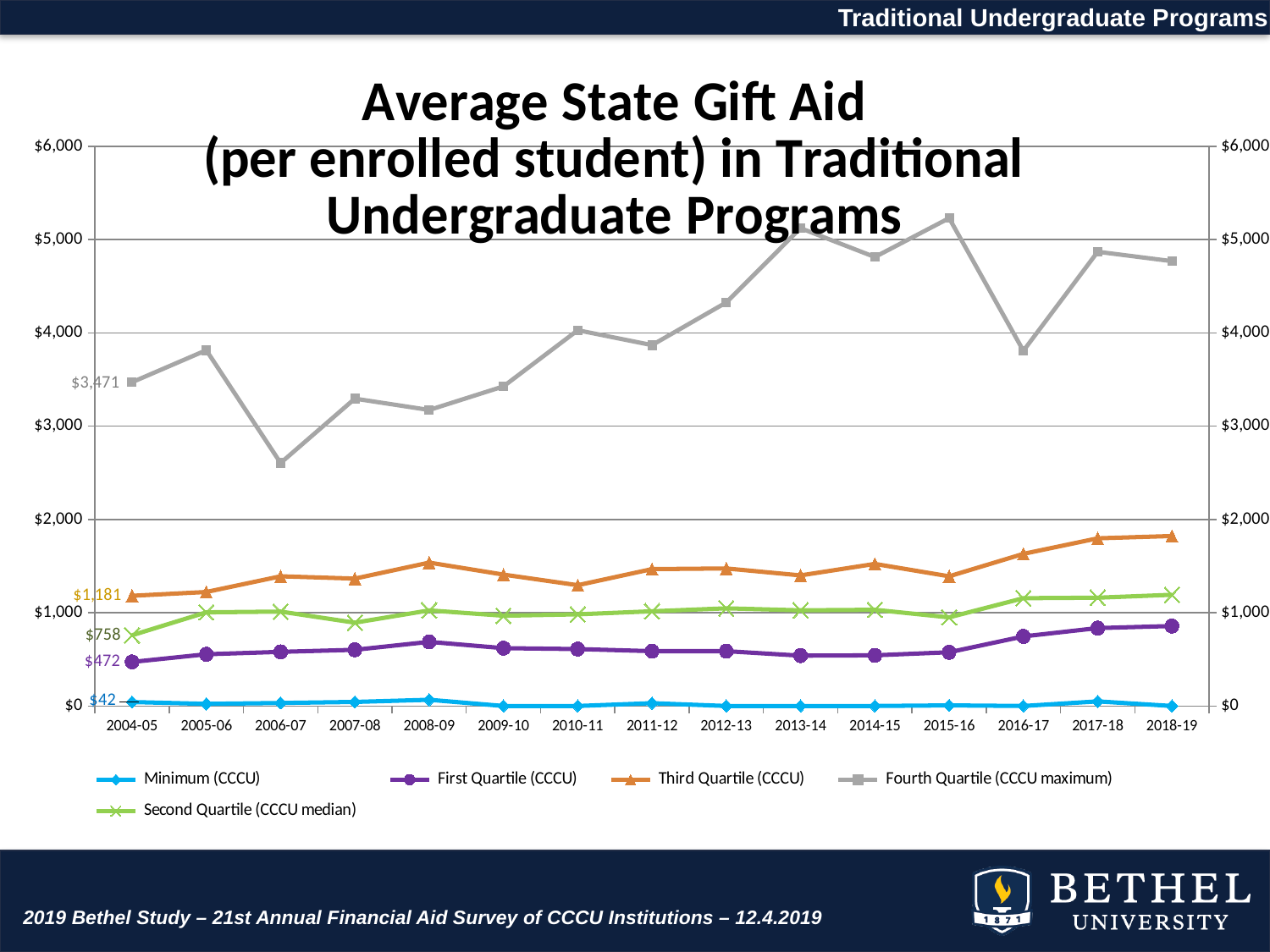
In which year is the Fourth Quartile (CCCU maximum) line at its lowest? 2006-07 Is the Fourth Quartile (CCCU maximum) value for 2006-07 greater or less than $3,000? less What is the Second Quartile (CCCU median) value for 2004-05? $758 What is the Fourth Quartile (CCCU maximum) value for 2004-05? $3,471 What is the Minimum (CCCU) value for 2004-05? $42 Does the Third Quartile (CCCU) line rise or fall from 2015-16 to 2018-19? rise What type of chart is shown on the slide? line chart What is the Third Quartile (CCCU) value for 2004-05? $1,181 Is the Fourth Quartile (CCCU maximum) value for 2015-16 greater or less than $5,000? greater How many series does the legend list? 5 What is the difference between the Fourth Quartile and Third Quartile values in 2004-05? $2,290 How many academic years are shown on the x axis? 15